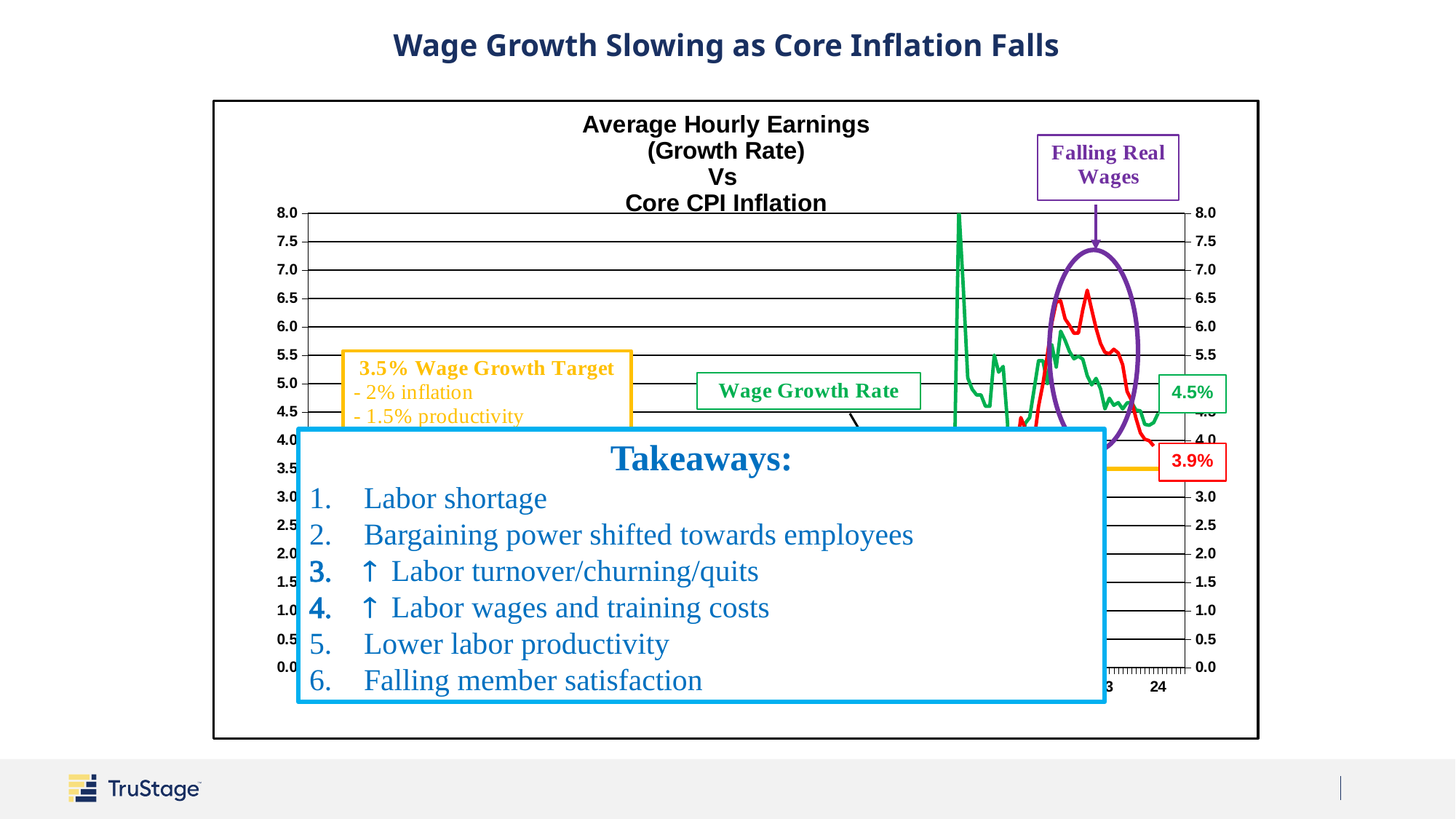
What value is shown in the red label at the right end of the chart? 3.9% Is the latest Wage Growth Rate value of 4.5% greater or less than the 3.5% wage growth target? greater Which is larger at the right end of the chart, the green Wage Growth Rate value (4.5%) or the red line value (3.9%)? Wage Growth Rate (4.5%) What is the difference between the labeled Wage Growth Rate value of 4.5% and the red line value of 3.9%? 0.6% What is the latest value labeled for the Wage Growth Rate line? 4.5% Is the red line's peak inside the purple circle greater or less than 6.0? greater What kind of chart is shown on the slide? line chart Does the red line rise or fall toward the right end of the chart after its peak? fall What is the title of the chart? Average Hourly Earnings (Growth Rate) Vs Core CPI Inflation Is the peak of the green Wage Growth Rate line greater or less than 7.5? greater What wage growth target is annotated on the chart? 3.5%